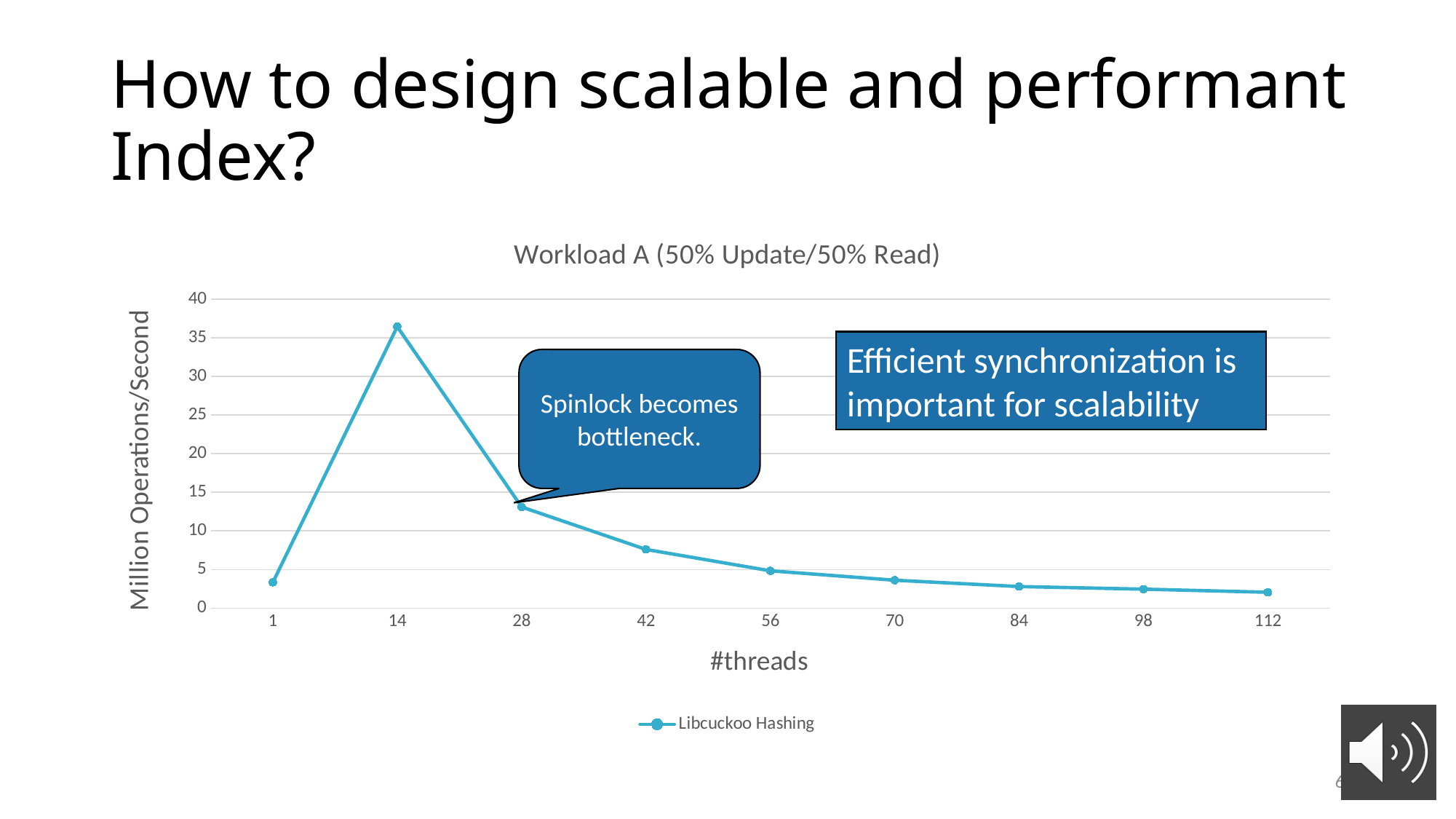
At which number of threads does Libcuckoo Hashing reach its highest throughput? 14 Is the value for 14 threads greater or less than 30? greater Do the values rise or fall as the number of threads increases from 14 to 112? fall How many thread counts are plotted along the x axis? 9 What is the name of the series in the chart legend? Libcuckoo Hashing Is the value for 1 thread greater or less than 5? less What is the title of the chart? Workload A (50% Update/50% Read) Which has the higher throughput, 28 threads or 56 threads? 28 threads How many series does the chart legend list? 1 Is the value for 28 threads greater or less than 15? less What kind of chart is shown on the slide? line chart